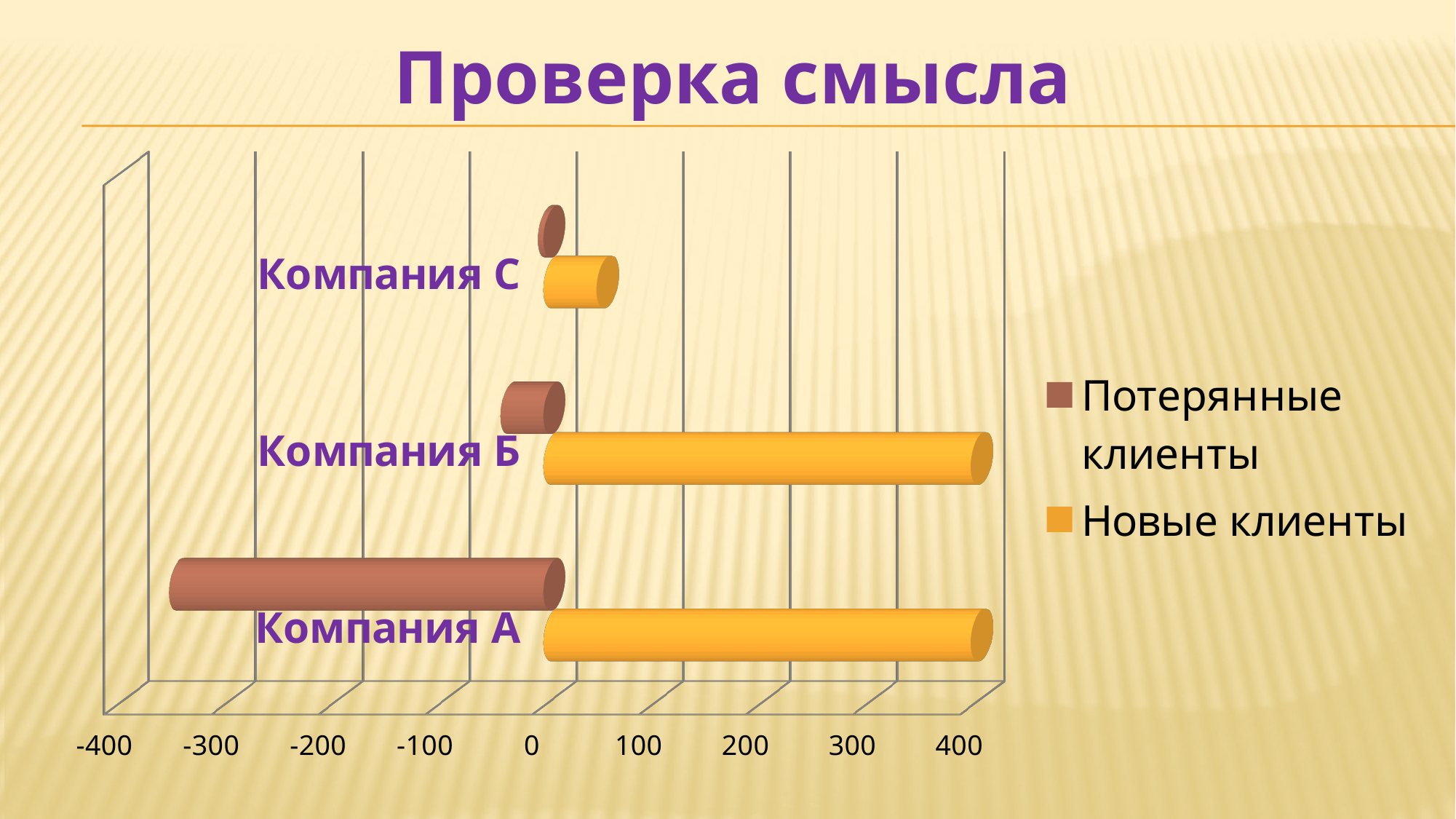
Which company has the most negative value for Потерянные клиенты? Компания А Which series is shown in yellow in the chart? Новые клиенты What is the title of the slide with the chart? Проверка смысла Is the value for Новые клиенты for Компания Б greater or less than 300? greater Is the value for Новые клиенты for Компания С greater or less than 100? less Which company has the lowest value for Новые клиенты? Компания С Is the value for Потерянные клиенты for Компания А greater or less than -300? less What kind of chart is shown on the slide? bar chart How many companies (categories) are shown in the chart? 3 How many series does the legend list? 2 Which is larger: the Новые клиенты value for Компания А or for Компания С? Компания А